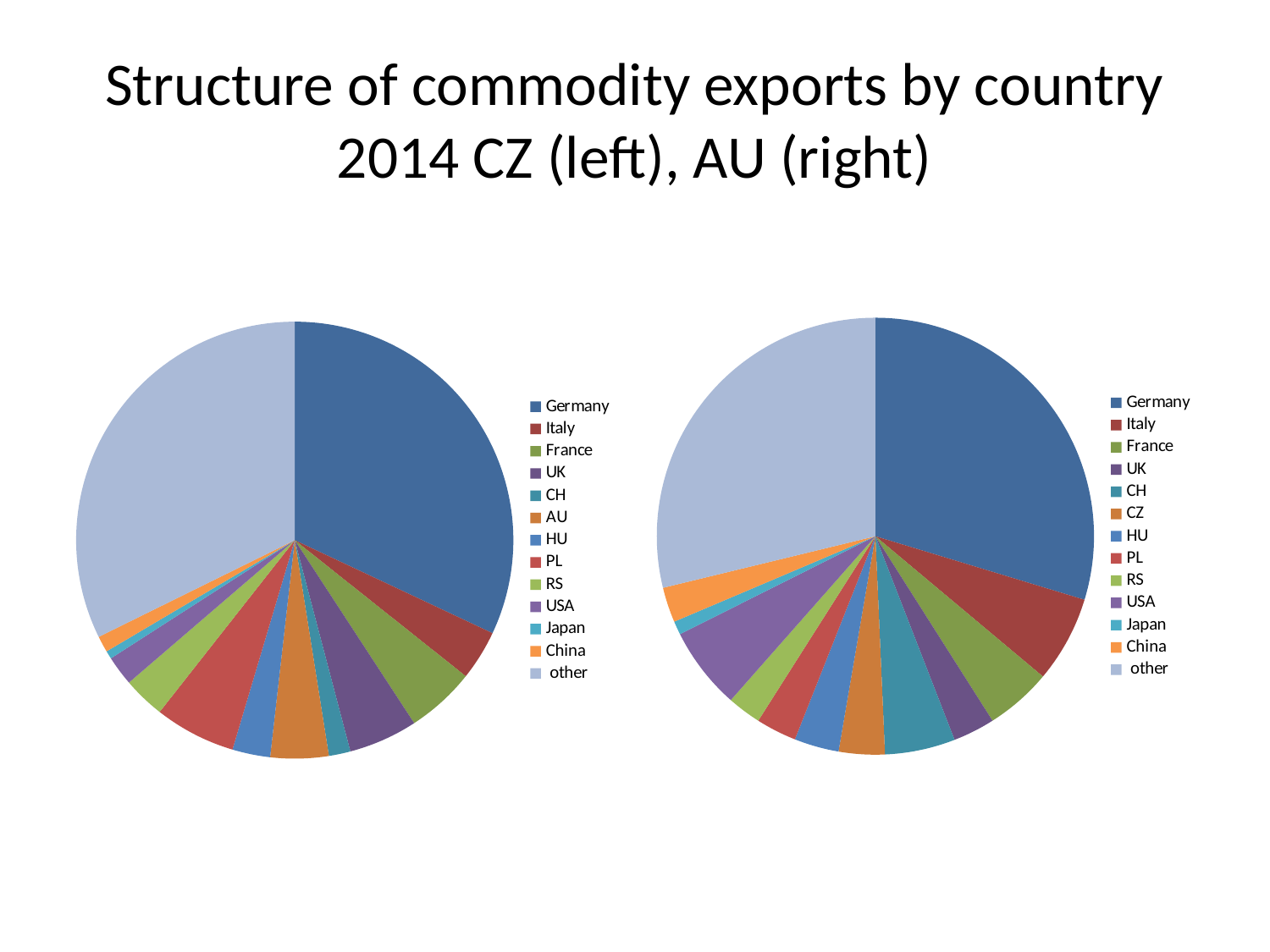
How many entries does the legend of the left chart (CZ) list? 13 How many slices does the right chart (AU) have? 13 In the left chart (CZ), which slice is larger, USA or Japan? USA In the right chart (AU), which country has the smallest slice? Japan In the left chart (CZ), which country has the smallest slice? Japan In the right chart (AU), which slice is larger, Italy or France? Italy Which legend entry appears in the left chart (CZ) but not in the right chart (AU)? AU What kind of chart is the left chart (CZ)? pie chart In the right chart (AU), which slice is larger, Germany or Italy? Germany What is the title of the slide? Structure of commodity exports by country 2014 CZ (left), AU (right)